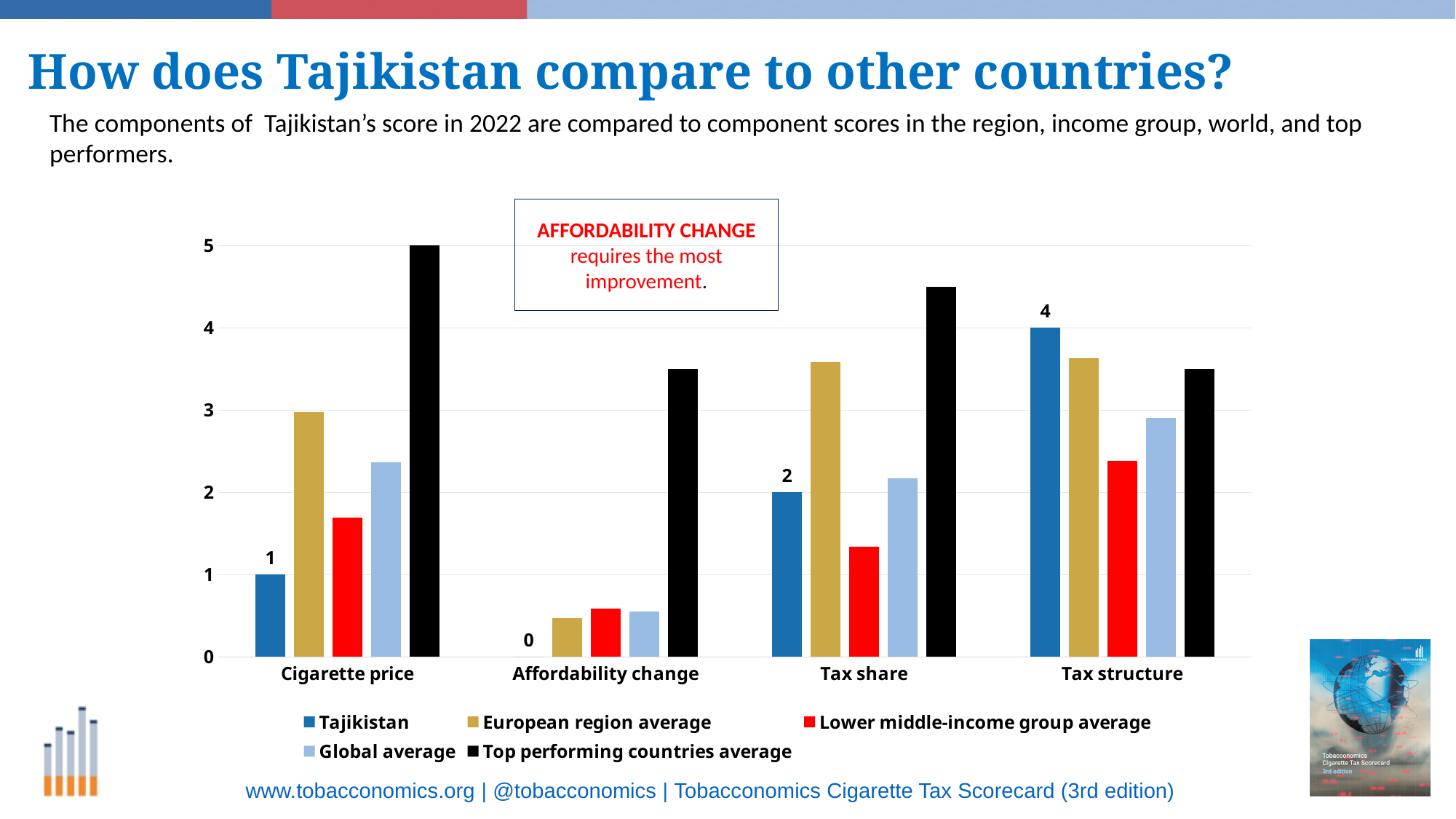
What is the Top performing countries average score for Cigarette price? 5 What is Tajikistan's score for Tax structure? 4 In which component does Tajikistan have its lowest score? Affordability change What is Tajikistan's score for Affordability change? 0 In which component does Tajikistan have its highest score? Tax structure How many component categories are shown on the x axis? 4 How much higher is Tajikistan's Tax structure score than its Cigarette price score? 3 What is Tajikistan's score for Cigarette price? 1 For Cigarette price, which is larger: Tajikistan or the Top performing countries average? Top performing countries average What kind of chart is shown on the slide? Bar chart How many series does the legend list? 5 Is the European region average for Tax share greater or less than 3? greater